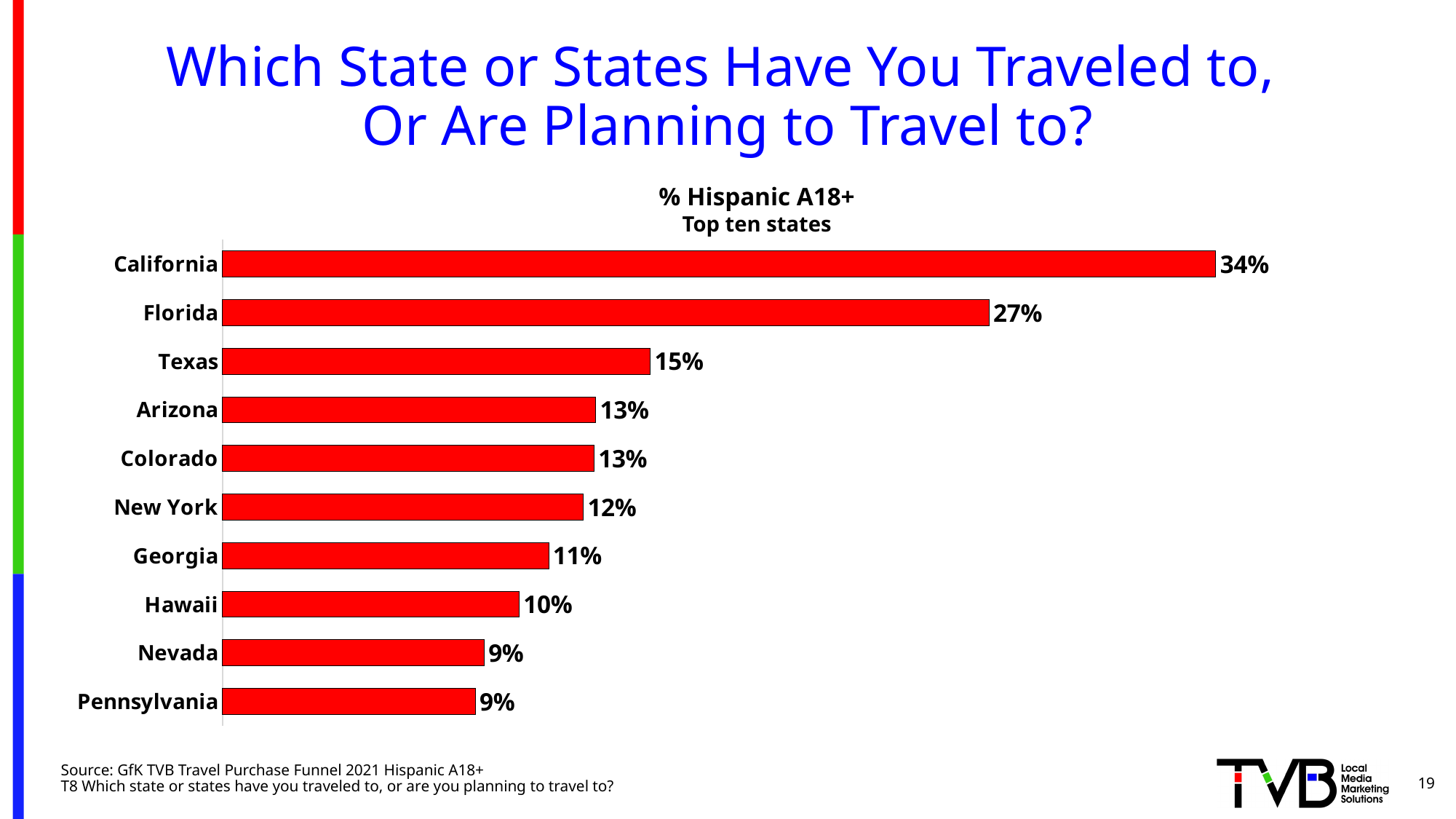
What is the value shown for Hawaii? 10% Which two states share the same value of 13%? Arizona and Colorado What is the value shown for Texas? 15% How many states are shown on the chart? 10 Which has a larger value, Georgia or Hawaii? Georgia What kind of chart is shown on the slide? bar chart What is the subtitle printed below '% Hispanic A18+' above the chart? Top ten states What is the difference in percentage points between California and Florida? 7 What is the difference in percentage points between Texas and New York? 3 What percentage of Hispanic A18+ respondents have traveled to or are planning to travel to California? 34% Which state has the highest percentage on the chart? California Which has a larger value, Florida or Texas? Florida